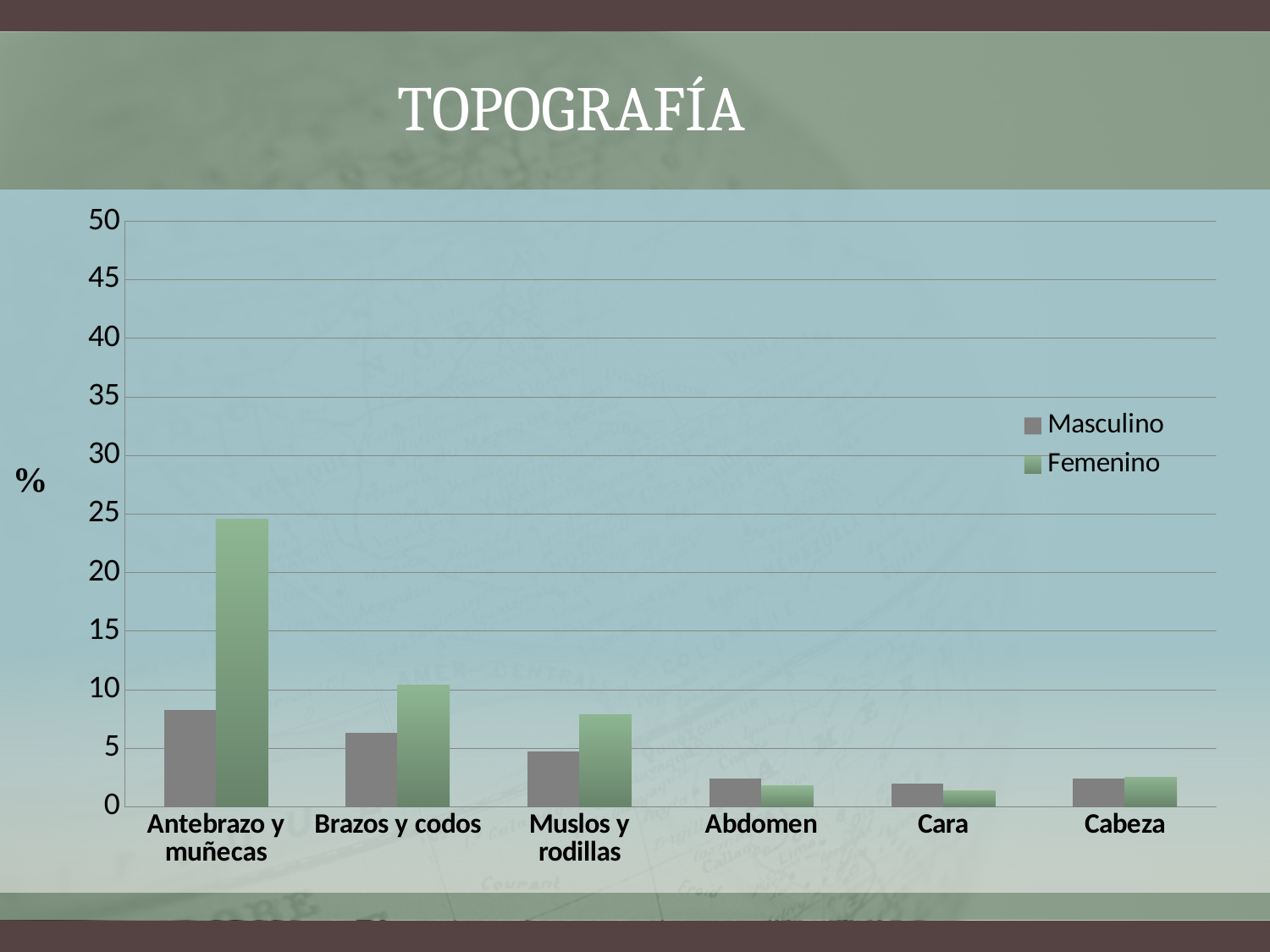
Which category has the highest Masculino value? Antebrazo y muñecas Is the Femenino value for Muslos y rodillas greater or less than 10? less How many categories are shown on the x axis? 6 Which category has the highest Femenino value? Antebrazo y muñecas For Antebrazo y muñecas, which series has the larger value, Masculino or Femenino? Femenino What is the title of the chart? TOPOGRAFÍA Do the Femenino values rise or fall across the first three categories, from Antebrazo y muñecas to Muslos y rodillas? fall Is the Femenino value for Antebrazo y muñecas greater or less than 20? greater Is the Masculino value for Antebrazo y muñecas greater or less than 10? less What kind of chart is shown on the slide? bar chart How many series does the legend list? 2